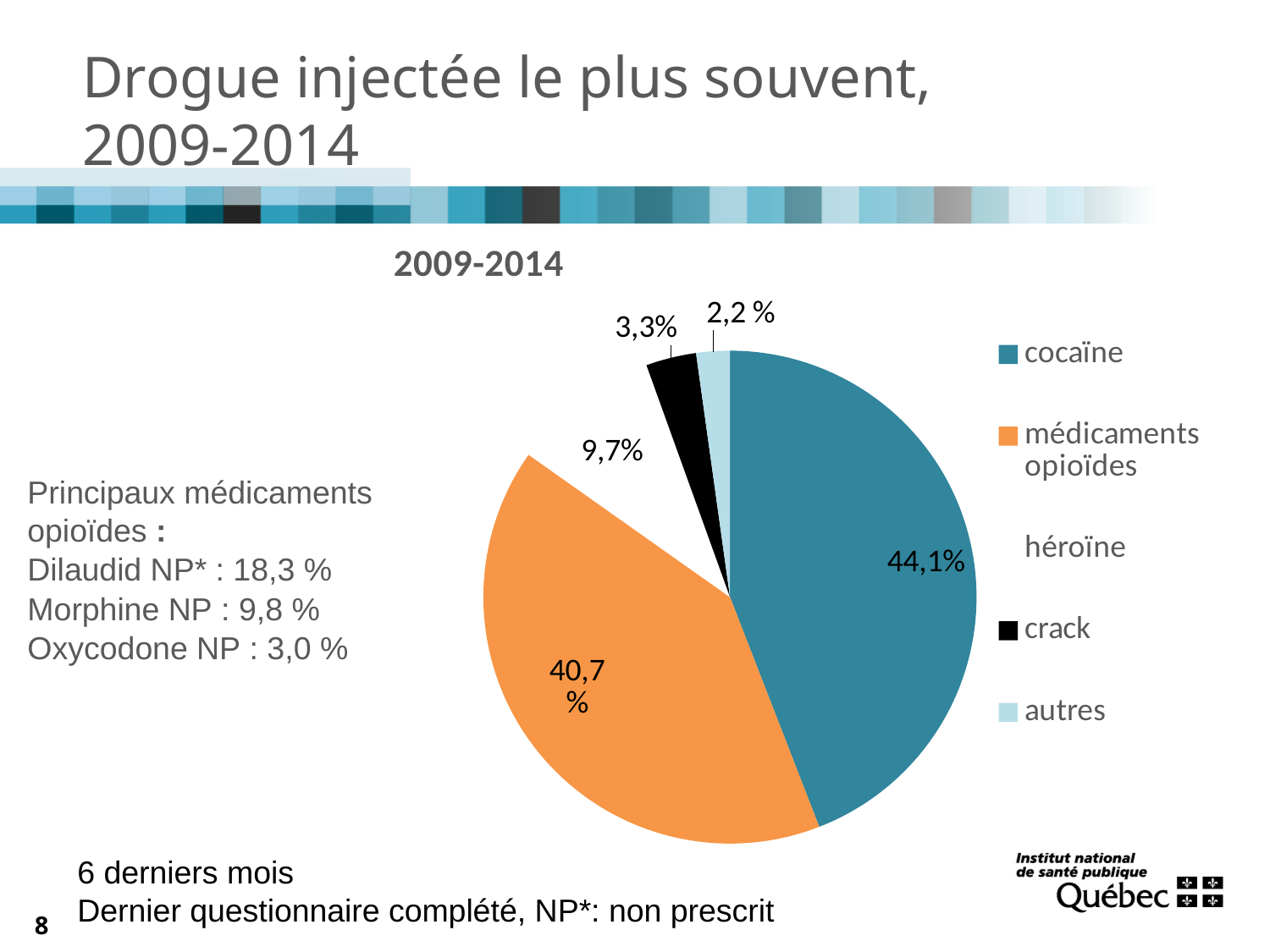
How many categories does the legend list? 5 What percentage of the pie is médicaments opioïdes? 40,7 % What percentage of the pie is crack? 3,3% What is the chart's title? 2009-2014 What percentage of the pie is héroïne? 9,7% Which category has the largest slice of the pie? cocaïne Which category has the smallest slice of the pie? autres What share of the pie does autres represent? 2,2 % What type of chart is shown on the slide? pie chart Which is larger, the share for héroïne or the share for crack? héroïne What is the difference in percentage points between cocaïne and médicaments opioïdes? 3,4 What percentage of the pie is cocaïne? 44,1%